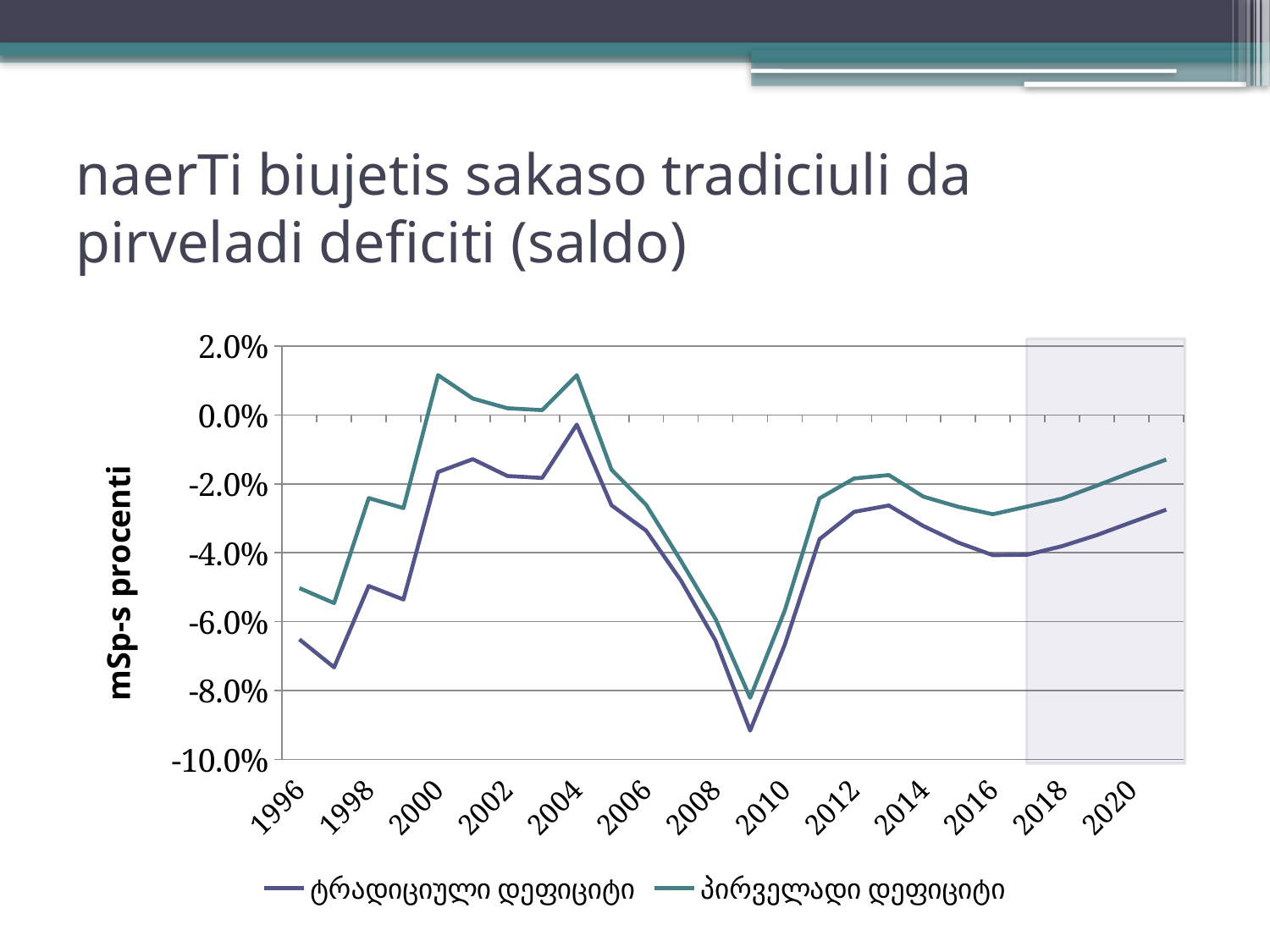
Is the value of ტრადიციული დეფიციტი in 2009 greater or less than -8.0%? less What is the first year shown on the horizontal axis? 1996 Which series has the higher value in 2009, ტრადიციული დეფიციტი or პირველადი დეფიციტი? პირველადი დეფიციტი Do the values of პირველადი დეფიციტი rise or fall between 2016 and 2020? rise Is the value of ტრადიციული დეფიციტი in 2000 greater or less than 0.0%? less Is the value of პირველადი დეფიციტი in 2000 greater or less than 0.0%? greater What is the title of the vertical axis? mSp-s procenti In which year does the ტრადიციული დეფიციტი series reach its lowest value? 2009 How many series does the legend list? 2 What kind of chart is shown on the slide? line chart Do the values of ტრადიციული დეფიციტი rise or fall between 2004 and 2009? fall